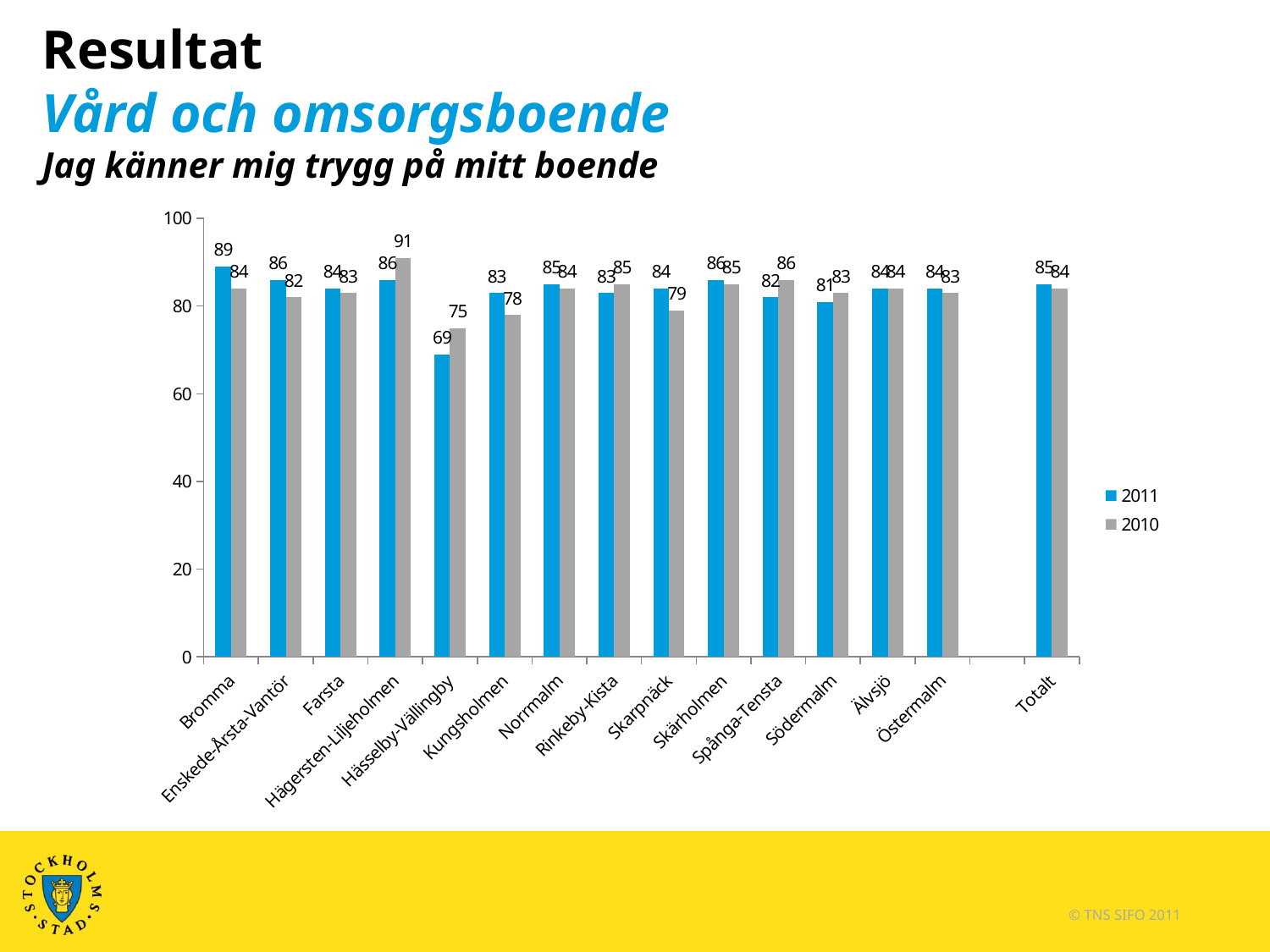
What is the difference between the 2010 and 2011 values for Hässelby-Vällingby? 6 Which is larger for Spånga-Tensta, the 2011 value or the 2010 value? 2010 What is the 2010 value for Kungsholmen? 78 What is the 2010 value for Hägersten-Liljeholmen? 91 What is the 2011 value for Totalt? 85 What is the 2011 value for Bromma? 89 Which category has the lowest 2011 value? Hässelby-Vällingby How many series does the legend list? 2 What kind of chart is shown on the slide? Bar chart How many categories are shown on the x axis? 15 Which category has the highest 2011 value? Bromma Which colour represents the 2010 series in the legend? Grey